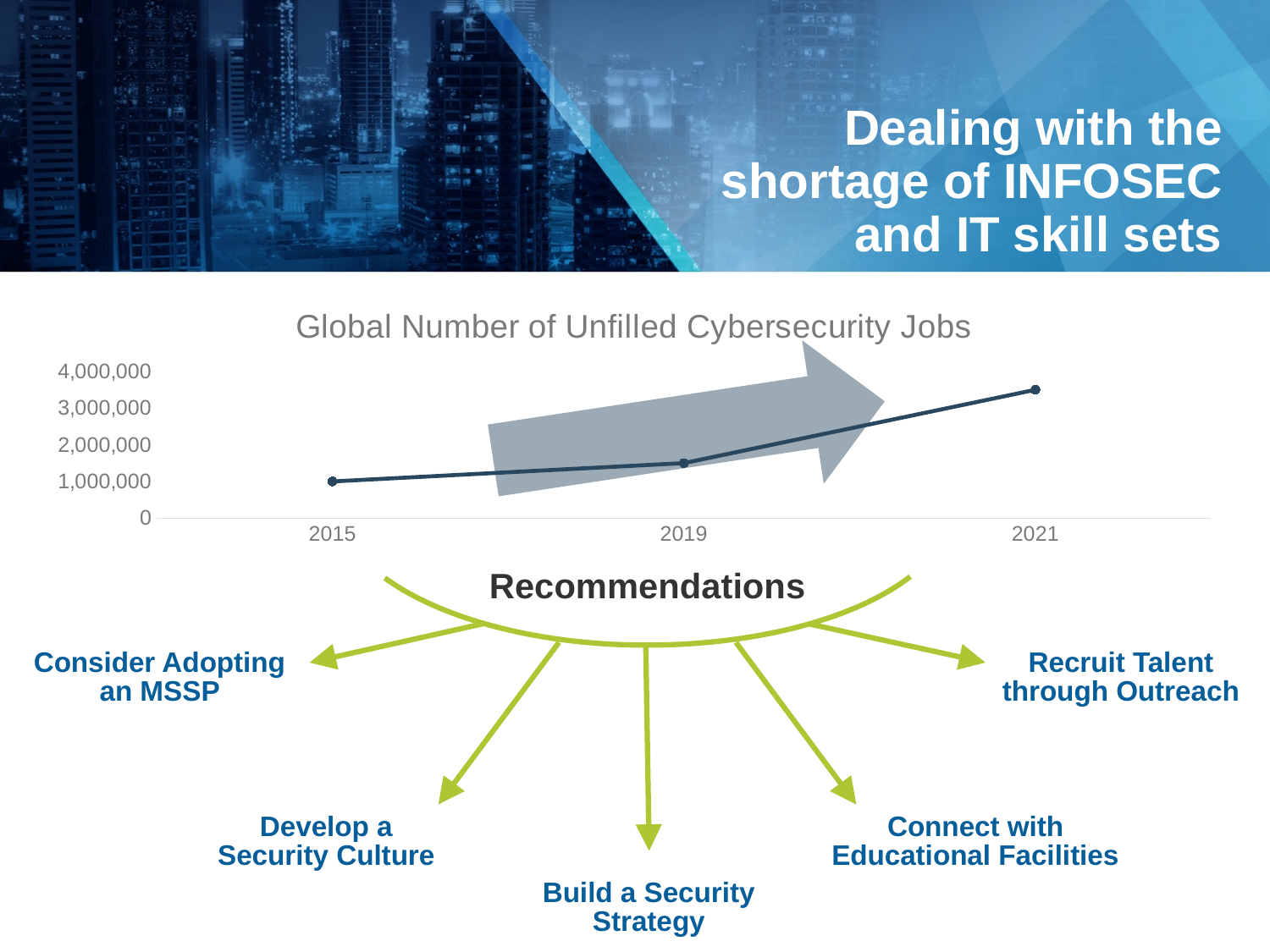
Is the value for 2021 greater or less than 3,000,000? greater How many data points are plotted on the line? 3 What is the highest value shown on the y axis? 4,000,000 Which year has a larger value, 2019 or 2021? 2021 Is the value for 2015 greater or less than 2,000,000? less Which year has the highest number of unfilled cybersecurity jobs? 2021 Which year has a larger value, 2015 or 2019? 2019 What kind of chart is shown on the slide? line chart Is the value for 2019 greater or less than 2,000,000? less Do the values rise or fall from 2015 to 2021? rise What is the title of the chart? Global Number of Unfilled Cybersecurity Jobs Which year has the lowest number of unfilled cybersecurity jobs? 2015